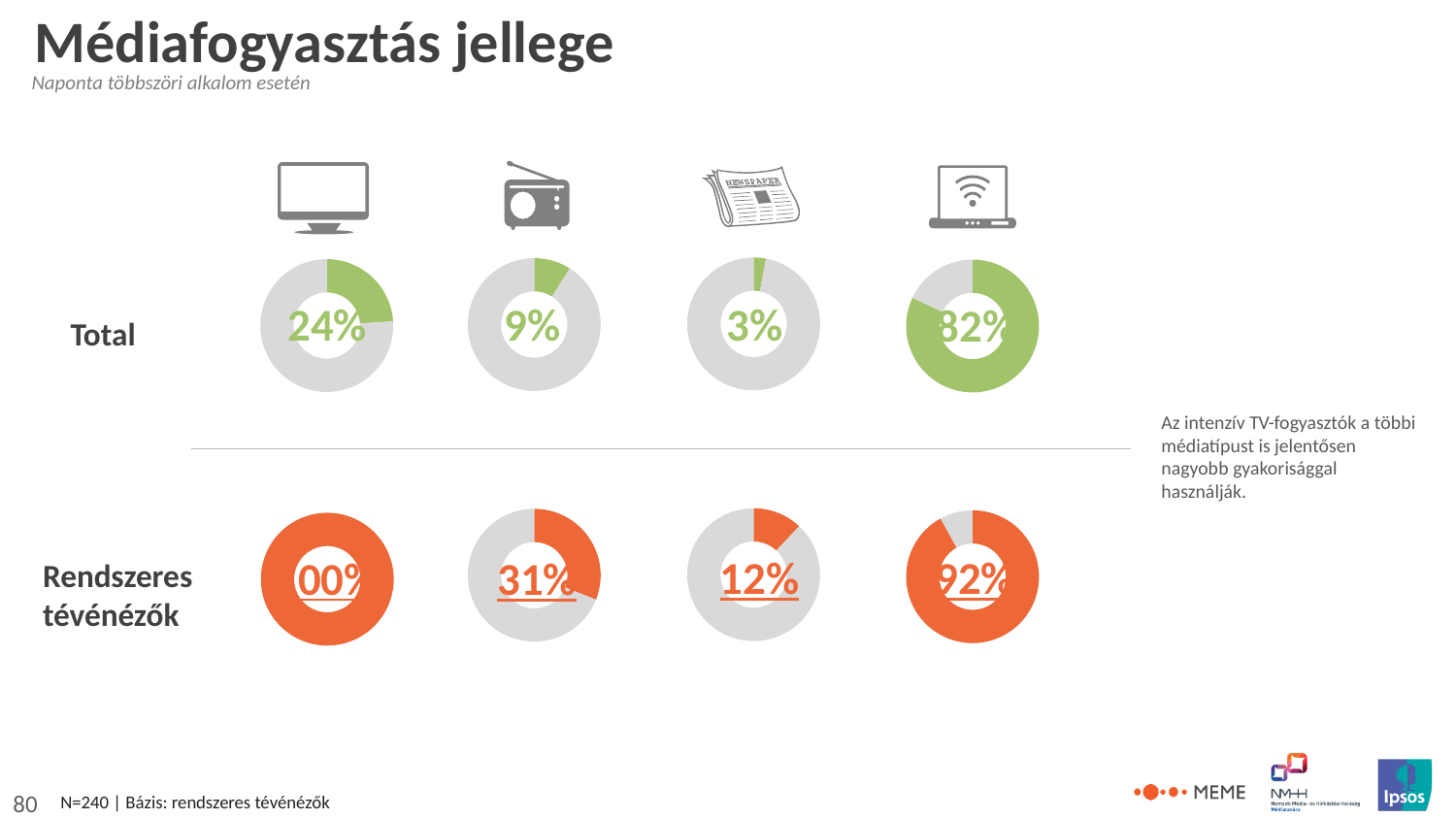
In the Total row, what value is shown in the donut chart under the radio icon? 9% What is the difference between the laptop icon values in the Rendszeres tévénézők row and the Total row? 10 percentage points In the Rendszeres tévénézők row, what value is shown in the donut chart under the newspaper icon? 12% Which is larger: the radio value in the Total row or the radio value in the Rendszeres tévénézők row? Rendszeres tévénézők In the Rendszeres tévénézők row, what value is shown in the donut chart under the radio icon? 31% What kind of chart is used to display the values on this slide? Donut (pie) chart In the Total row, what value is shown in the donut chart under the laptop icon? 82% In the Rendszeres tévénézők row, what value is shown in the donut chart under the laptop icon? 92% In the Total row, what value is shown in the donut chart under the television icon? 24% In the Total row, which media type has the lowest value? Newspaper In the Total row, which media type has the highest value? Laptop (internet) In the Total row, what value is shown in the donut chart under the newspaper icon? 3%